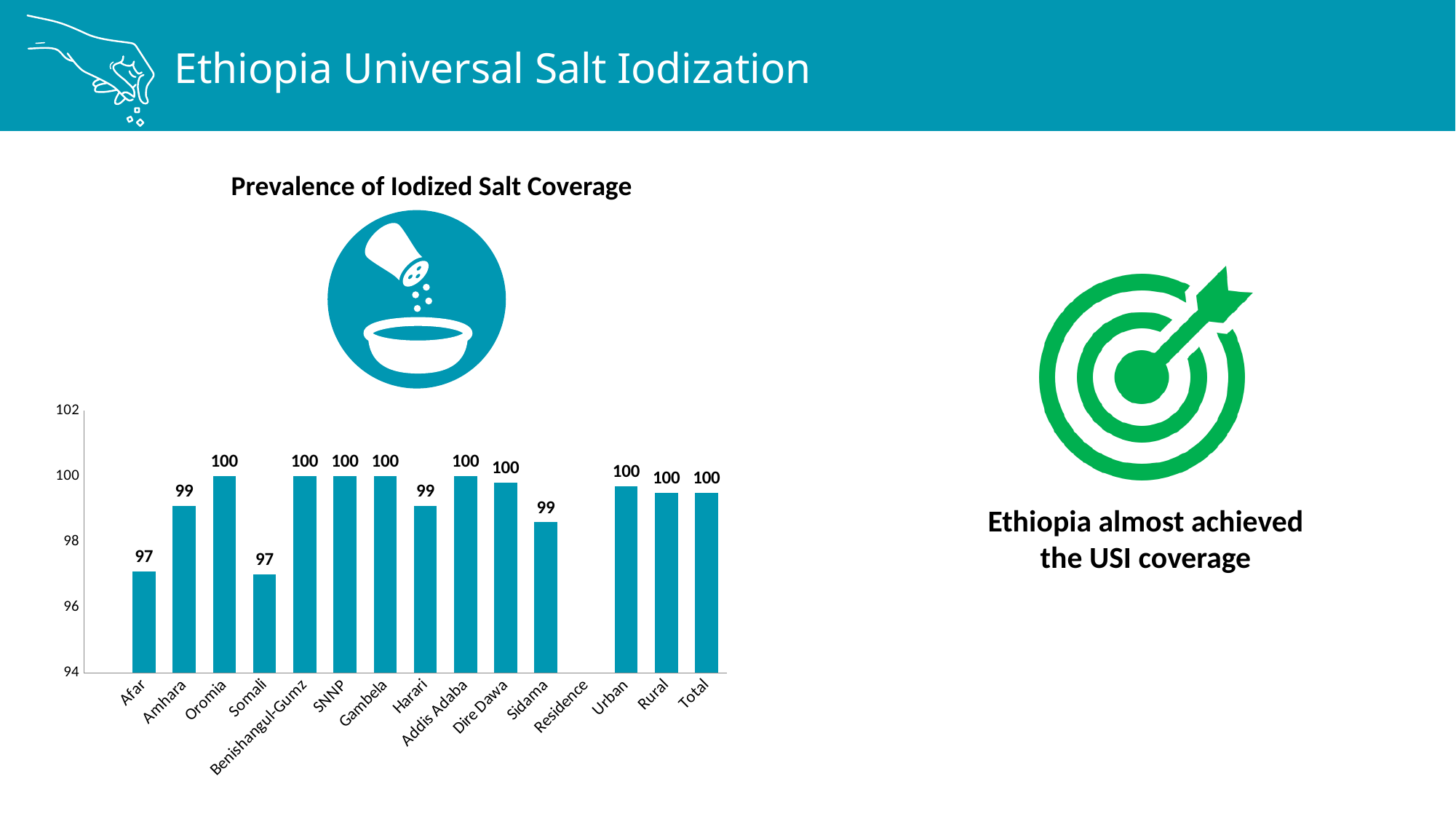
What is the title of the chart? Prevalence of Iodized Salt Coverage Which is larger, the value for Amhara or the value for Afar? Amhara What type of chart is shown on the slide? bar chart What is the value for Total? 100 What is the value for Afar? 97 What is the value for Amhara? 99 What is the value for Somali? 97 What is the value for Sidama? 99 What is the difference between the values for Oromia and Afar? 3 Is the value for Somali greater or less than 98? less What is the difference between the values for Harari and Somali? 2 How many bars are plotted in the chart? 14